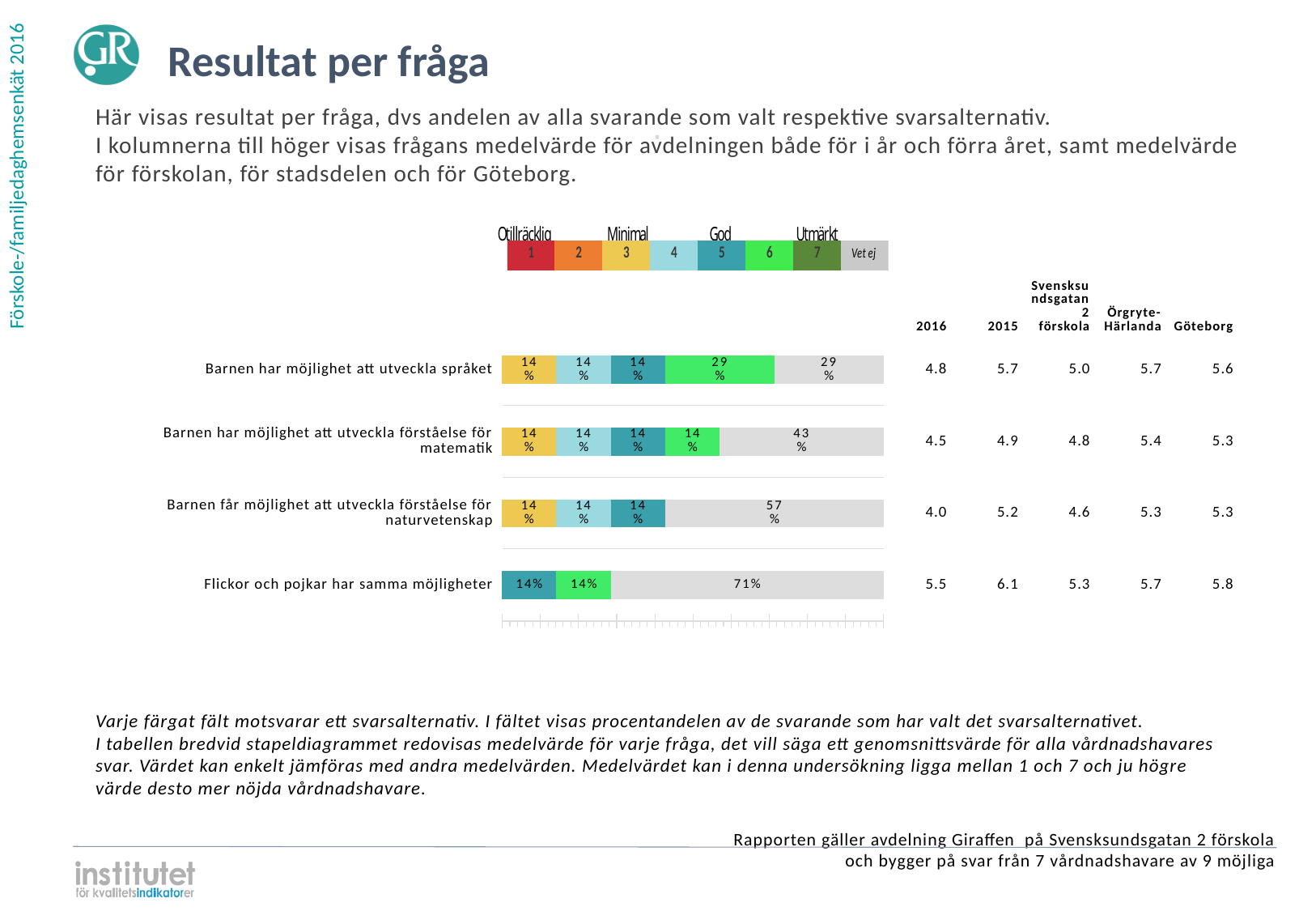
What is the grey 'Vet ej' share for 'Barnen får möjlighet att utveckla förståelse för naturvetenskap'? 57% In the table next to the chart, what is the 2016 mean value for 'Barnen får möjlighet att utveckla förståelse för naturvetenskap'? 4.0 Is the green (answer 6) segment larger for 'Barnen har möjlighet att utveckla språket' or for 'Barnen har möjlighet att utveckla förståelse för matematik'? Barnen har möjlighet att utveckla språket What percentage of respondents answered 'Vet ej' (grey segment) for 'Flickor och pojkar har samma möjligheter'? 71% What label does the legend give to answer options 1 and 2? Otillräcklig What kind of chart is shown on the slide? Stacked bar chart What is the difference between the 'Vet ej' share for 'Barnen har möjlighet att utveckla förståelse för matematik' (43%) and for 'Barnen har möjlighet att utveckla språket' (29%)? 14% How many questions (bars) are plotted in the chart? 4 Which question has the largest grey 'Vet ej' segment? Flickor och pojkar har samma möjligheter How many response categories does the legend above the chart list, including 'Vet ej'? 8 Which question has the smallest grey 'Vet ej' segment? Barnen har möjlighet att utveckla språket What percentage of respondents chose answer 6 (green segment) for 'Barnen har möjlighet att utveckla språket'? 29%